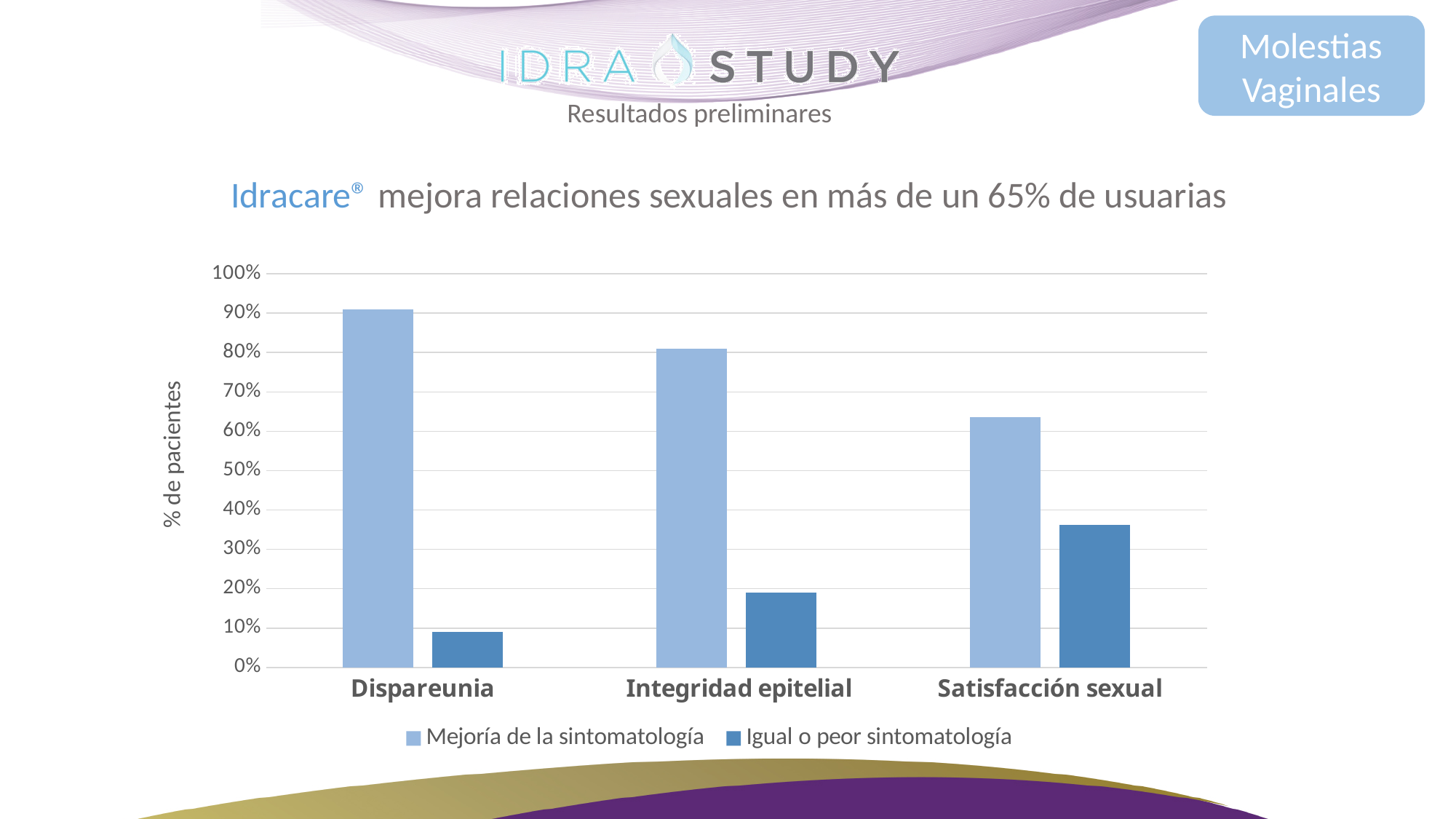
Which category has the highest value for 'Igual o peor sintomatología'? Satisfacción sexual Which category has the lowest value for 'Igual o peor sintomatología'? Dispareunia What kind of chart is shown on the slide? bar chart Do the 'Mejoría de la sintomatología' values rise or fall from left to right across the categories? fall How many series does the chart legend list? 2 Is the 'Mejoría de la sintomatología' value for Satisfacción sexual greater or less than 60%? greater How many categories are shown on the x axis of the chart? 3 For Satisfacción sexual, which series has the larger value: 'Mejoría de la sintomatología' or 'Igual o peor sintomatología'? Mejoría de la sintomatología Is the 'Mejoría de la sintomatología' value for Dispareunia greater or less than 80%? greater Which category has the highest value for 'Mejoría de la sintomatología'? Dispareunia Which category has the lowest value for 'Mejoría de la sintomatología'? Satisfacción sexual Is the 'Igual o peor sintomatología' value for Integridad epitelial greater or less than 30%? less